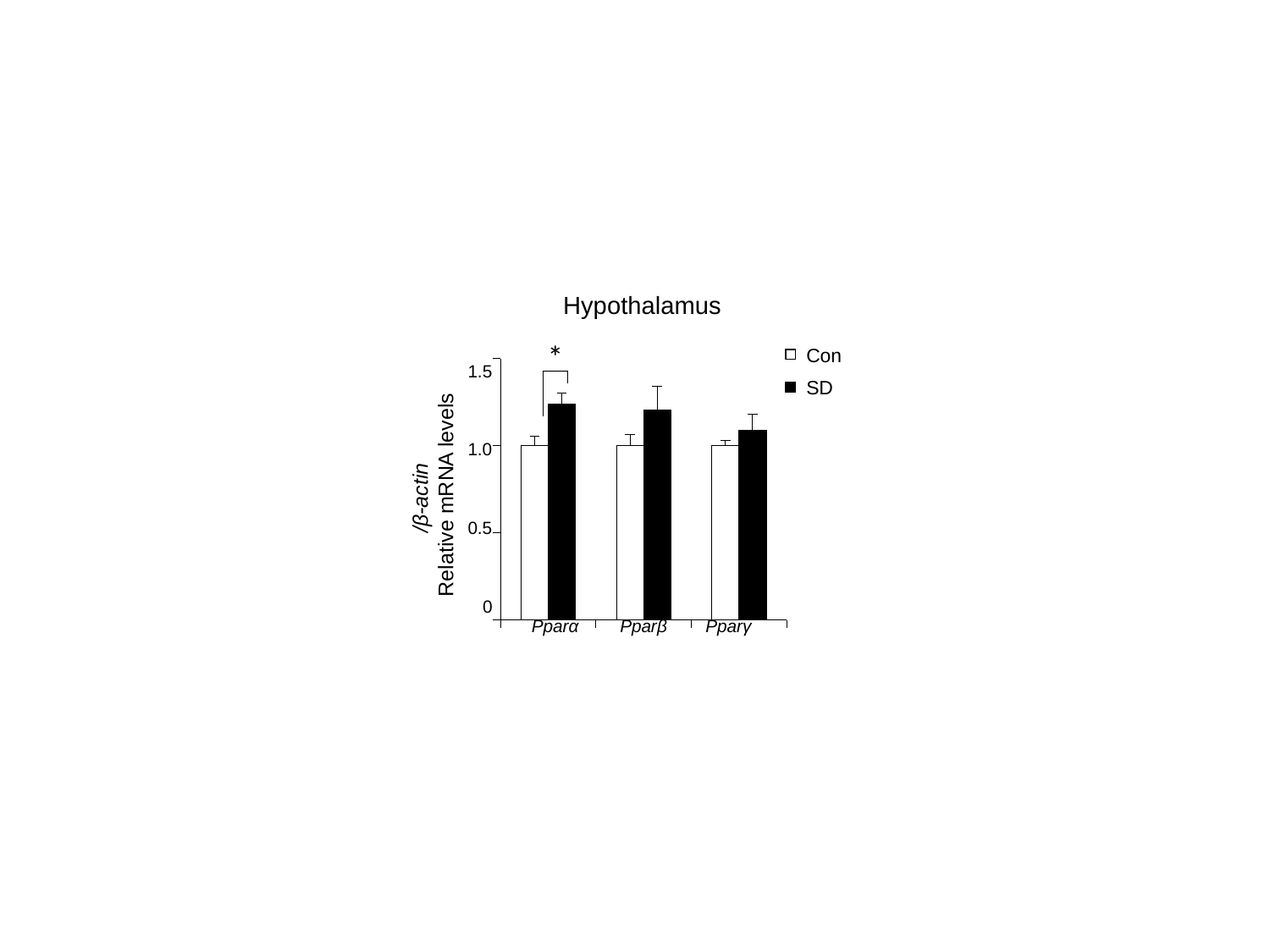
Is the SD value for Pparβ greater or less than 1.5? less What is the title of the chart? Hypothalamus Is the SD value for Pparα greater or less than 1.0? greater What is the Con value for Pparγ? 1.0 What is the Con value for Pparα? 1.0 Which category is marked with an asterisk indicating significance? Pparα How many gene categories are shown on the x axis? 3 How many series does the legend list? 2 Is the SD value for Pparγ greater or less than 1.0? greater What kind of chart is shown on the slide? bar chart For Pparα, which is larger, the Con value or the SD value? SD Which category has the lowest SD value? Pparγ